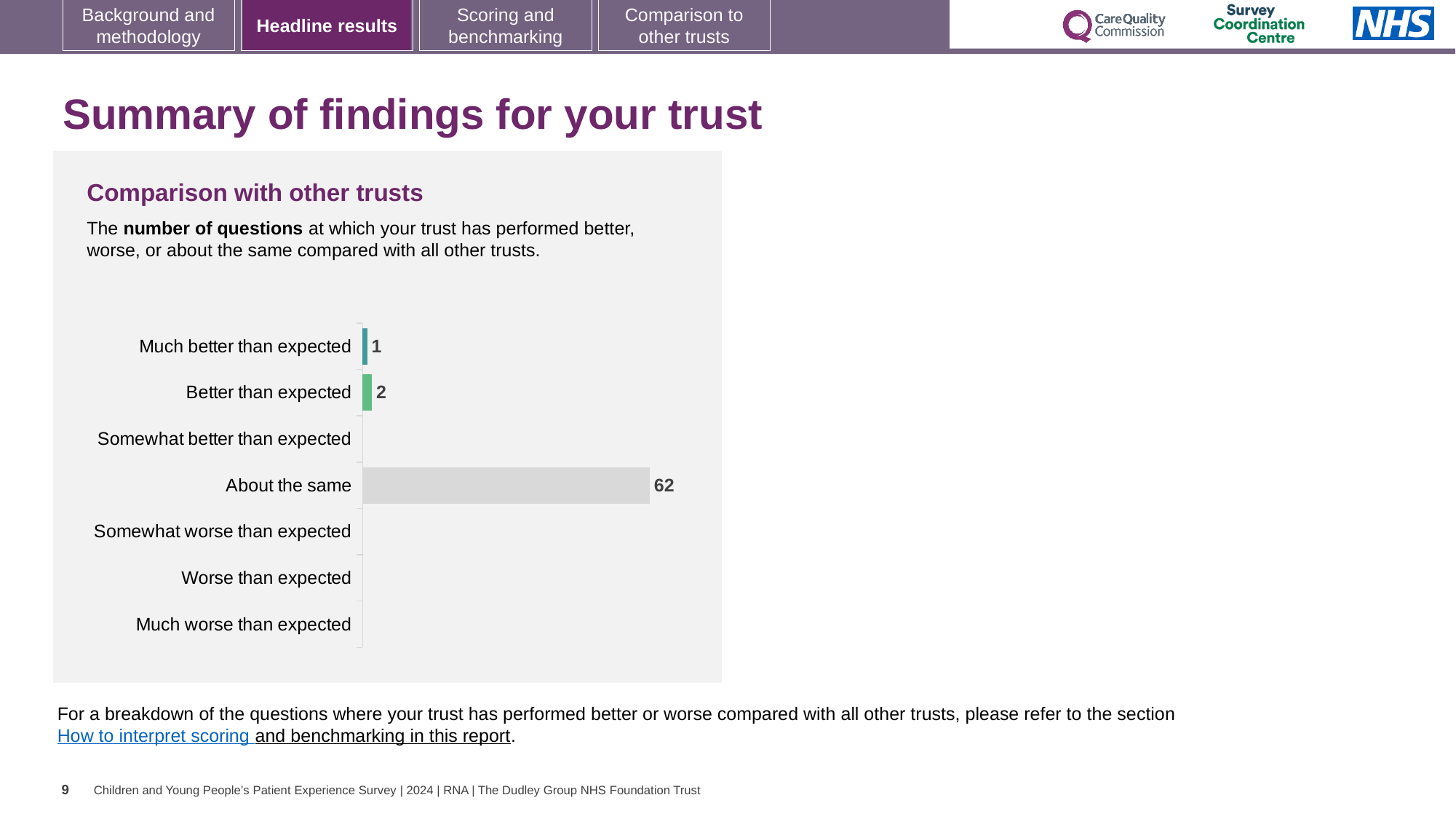
How many categories on the chart have a visible bar? 3 What kind of chart is shown on the slide? Bar chart What is the difference between the values for "Better than expected" and "Much better than expected"? 1 Which category has the highest value? About the same What is the value for "About the same"? 62 What is the difference between the values for "About the same" and "Better than expected"? 60 Which is larger, the value for "Better than expected" or the value for "Much better than expected"? Better than expected What is the value for "Much better than expected"? 1 How many categories are listed on the chart? 7 What is the total of the three labelled bars on the chart? 65 What is the title of the chart? Comparison with other trusts What is the value for "Better than expected"? 2